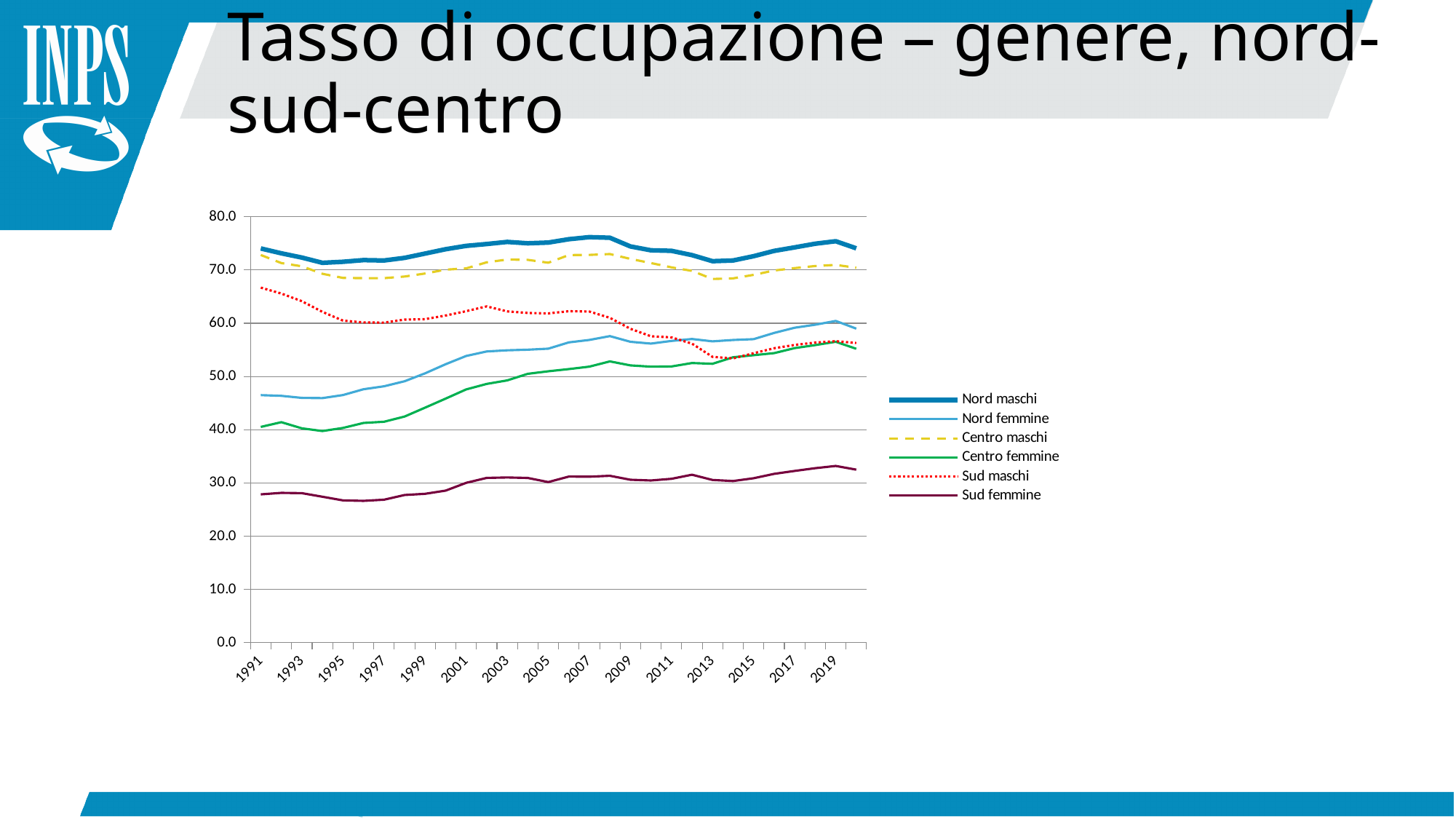
How many year labels are shown on the x axis? 15 In 1991, which is larger: Sud maschi or Nord femmine? Sud maschi Which series has the lowest values across the whole period? Sud femmine Which series has the highest values across the whole period? Nord maschi How many series does the legend list? 6 Is the value for Sud femmine in 1997 greater or less than 30? less Does the Centro femmine series rise or fall from 1991 to 2019? rise Is the value for Nord femmine in 2001 greater or less than 50? greater Which series is drawn with a red dotted line? Sud maschi Is the value for Sud femmine in 2019 greater or less than 40? less What kind of chart is shown on the slide? line chart